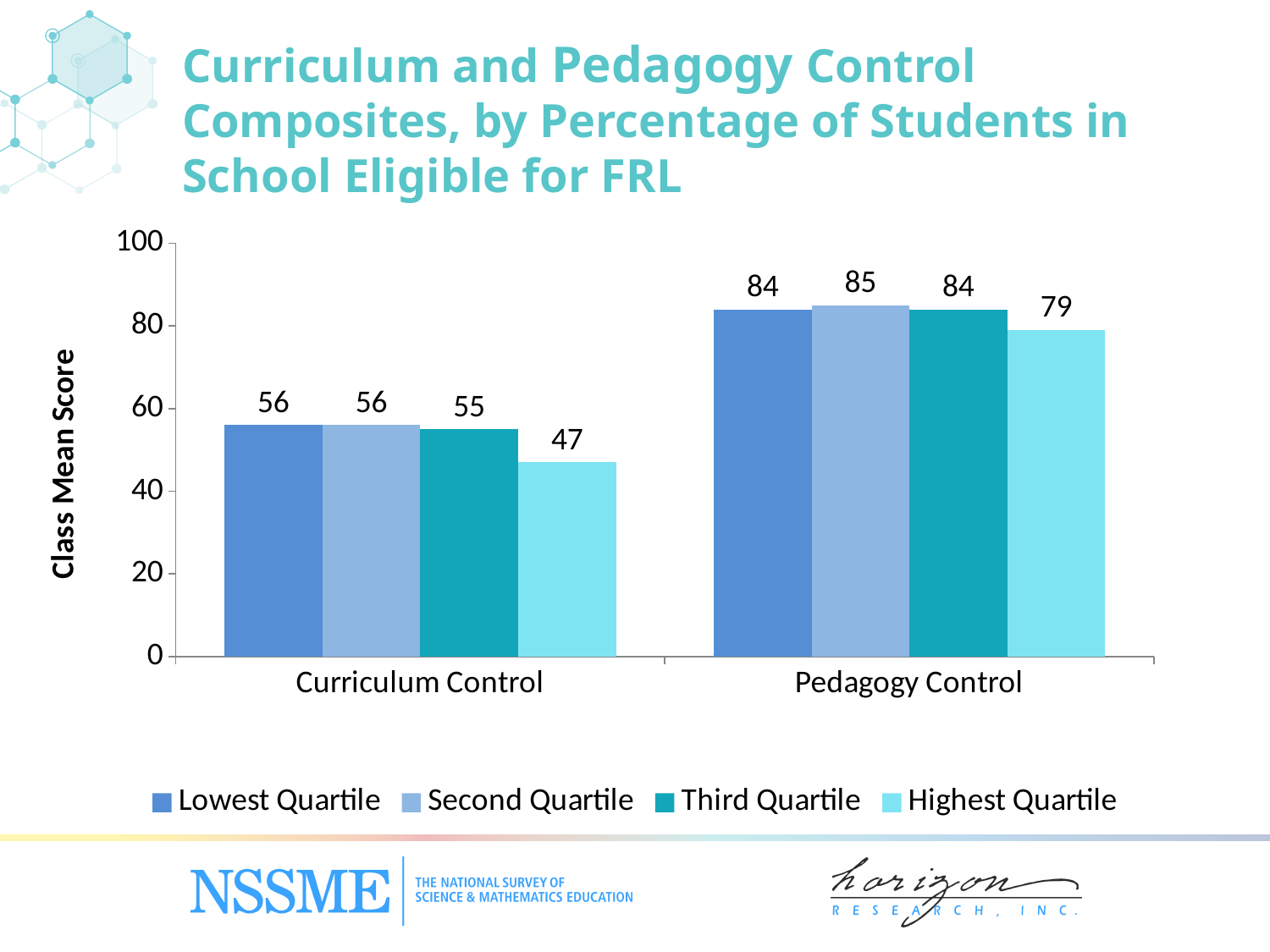
Is the Highest Quartile score for Pedagogy Control greater or less than 80? less How many series does the legend list? 4 What kind of chart is shown on the slide? Bar chart Which quartile has the lowest Class Mean Score for Pedagogy Control? Highest Quartile What is the Class Mean Score for the Second Quartile in Pedagogy Control? 85 What is the Class Mean Score for the Third Quartile in Curriculum Control? 55 Which quartile has the highest Class Mean Score for Pedagogy Control? Second Quartile What is the difference between the Lowest Quartile and Highest Quartile scores for Curriculum Control? 9 Which is larger: the Highest Quartile score for Curriculum Control or the Highest Quartile score for Pedagogy Control? Pedagogy Control How many categories are shown on the x axis? 2 What is the Class Mean Score for the Highest Quartile in Curriculum Control? 47 What is the difference between the Pedagogy Control and Curriculum Control scores for the Lowest Quartile? 28